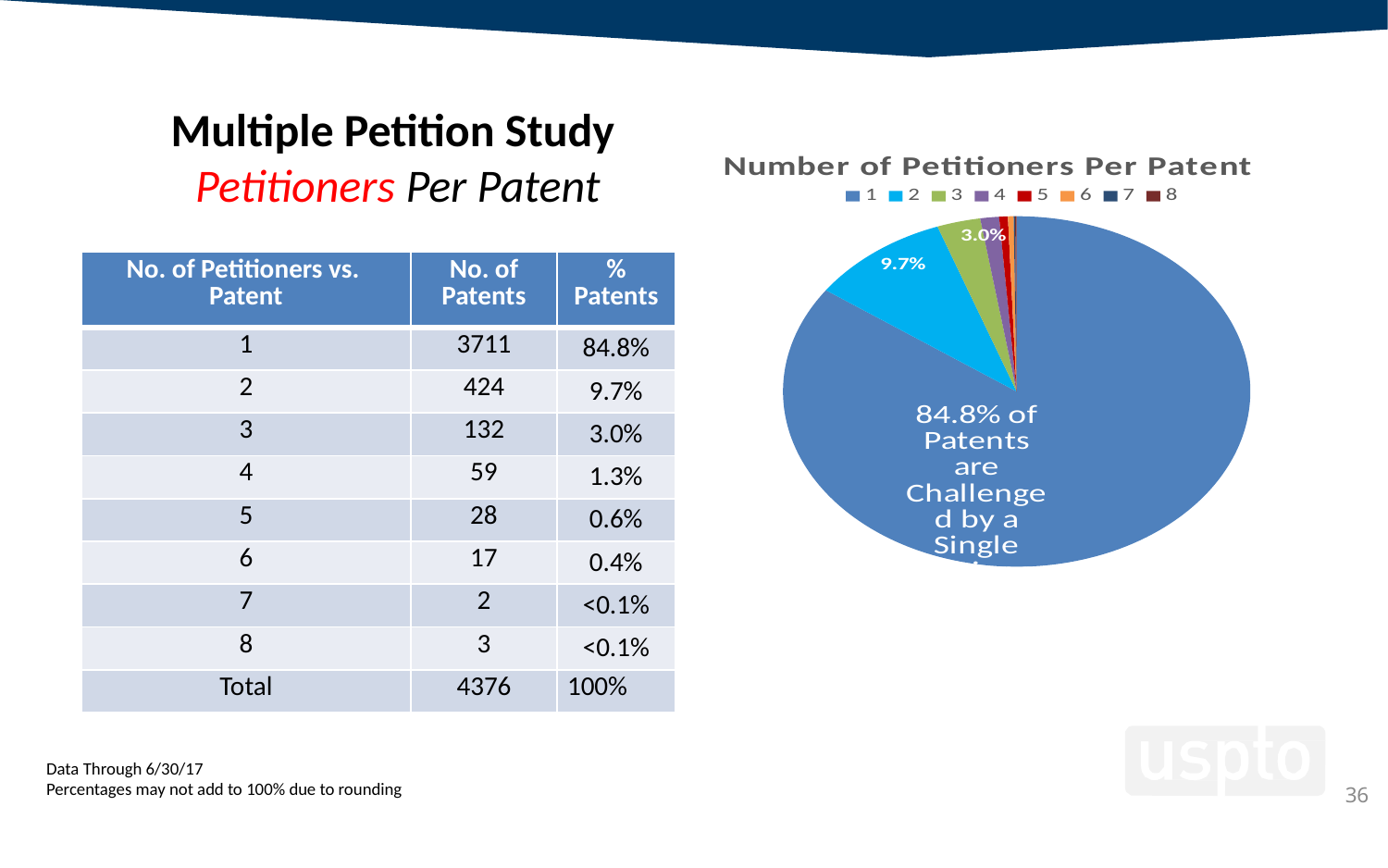
Which category has the largest slice in the pie chart? 1 What is the title of the pie chart? Number of Petitioners Per Patent Is the share for 1 petitioner in the pie chart greater or less than 80%? greater What colour is the largest slice of the pie chart? Blue In the pie chart, is the slice for 2 petitioners larger or smaller than the slice for 3 petitioners? Larger How many entries does the legend of the pie chart list? 8 In the pie chart, what share is labelled for the slice for 3 petitioners? 3.0% What is the difference in percentage points between the slice for 2 petitioners and the slice for 3 petitioners in the pie chart? 6.7 What is the difference in percentage points between the slice for 1 petitioner and the slice for 2 petitioners in the pie chart? 75.1 In the pie chart, what share is labelled for the slice for 2 petitioners? 9.7% In the pie chart, what share of patents is challenged by a single petitioner (category 1)? 84.8% What kind of chart is shown on the slide? Pie chart